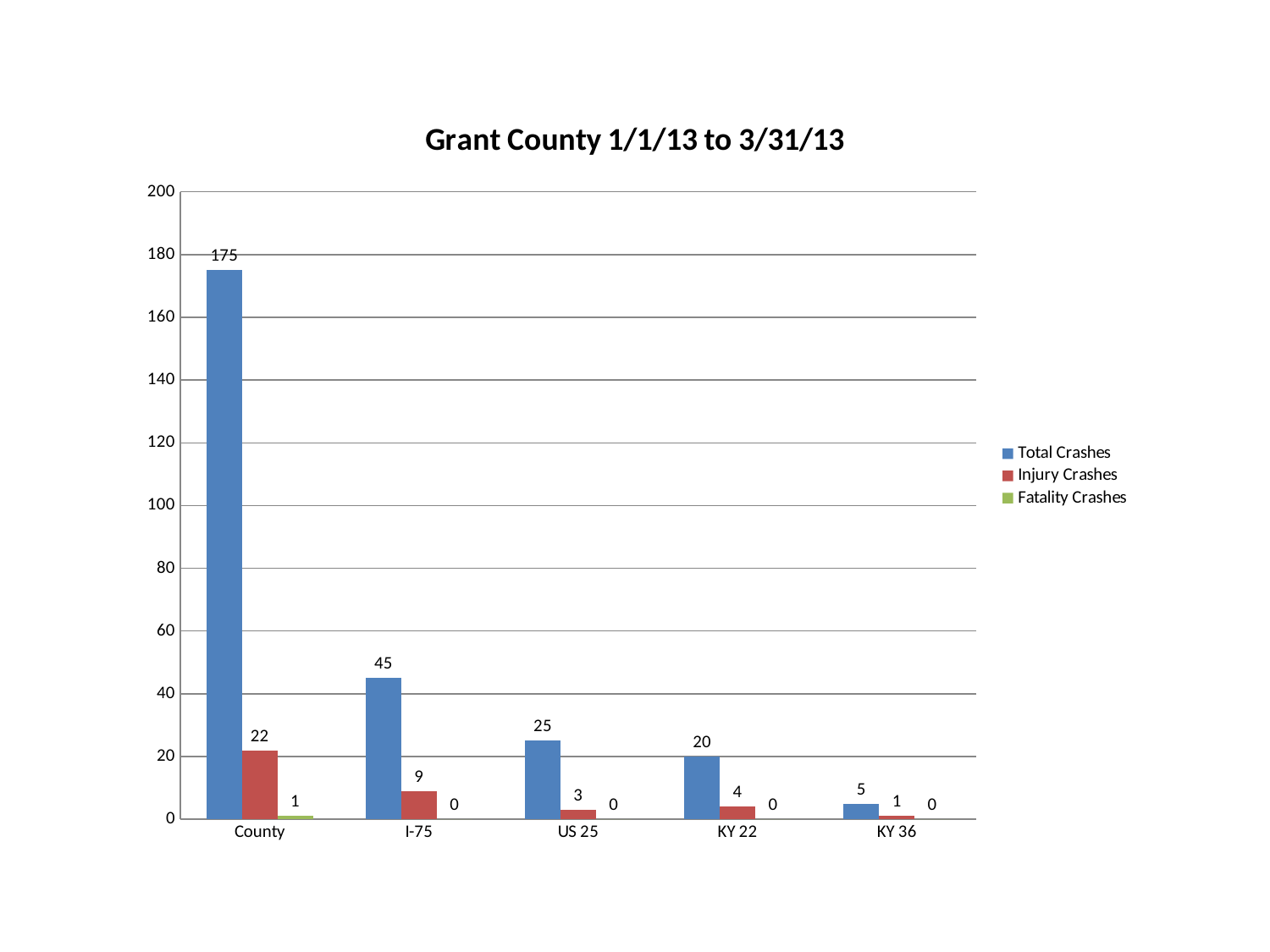
Which category has the lowest Injury Crashes? KY 36 How many categories are shown on the x axis? 5 What kind of chart is shown on the slide? Bar chart What is the difference between Total Crashes for I-75 and Total Crashes for US 25? 20 What is the title of the chart? Grant County 1/1/13 to 3/31/13 What is the value of Fatality Crashes for County? 1 What is the value of Total Crashes for KY 36? 5 What is the value of Total Crashes for County? 175 What is the value of Injury Crashes for I-75? 9 Which is larger: Injury Crashes for US 25 or Injury Crashes for KY 22? KY 22 How many series does the legend list? 3 Which category has the highest Total Crashes? County